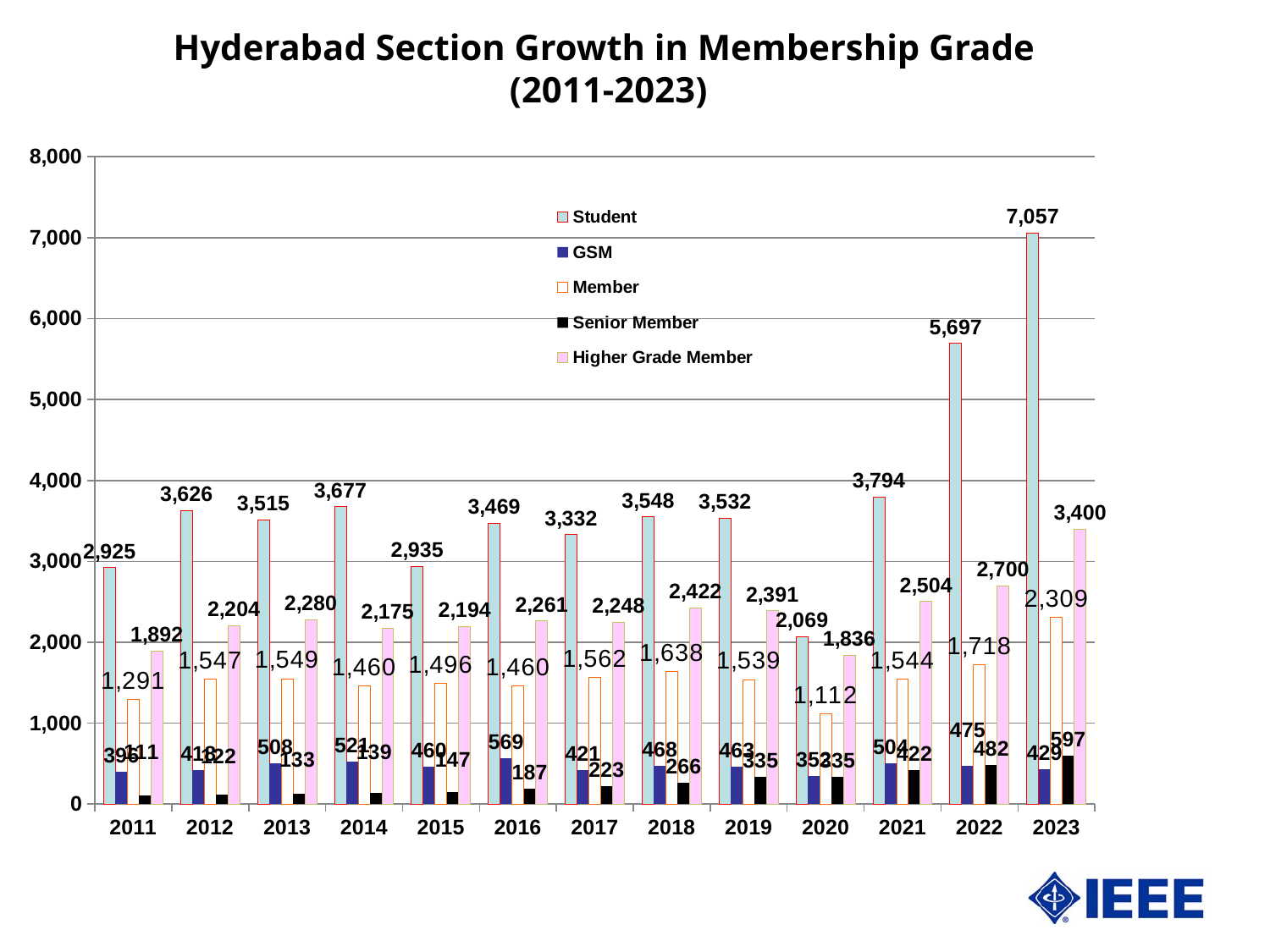
Which year has the highest Student value? 2023 How many years are shown on the x axis? 13 Do the Senior Member values generally rise or fall from 2011 to 2023? rise What is the Student value for 2023? 7,057 What is the Member value for 2023? 2,309 Which year has the larger Member value, 2017 or 2018? 2018 Is the Student value for 2021 greater or less than 3,000? greater What kind of chart is shown on the slide? Bar chart What is the difference between the Student values for 2023 and 2022? 1,360 Which year has the lowest Student value? 2020 What is the Higher Grade Member value for 2022? 2,700 How many series does the legend list? 5